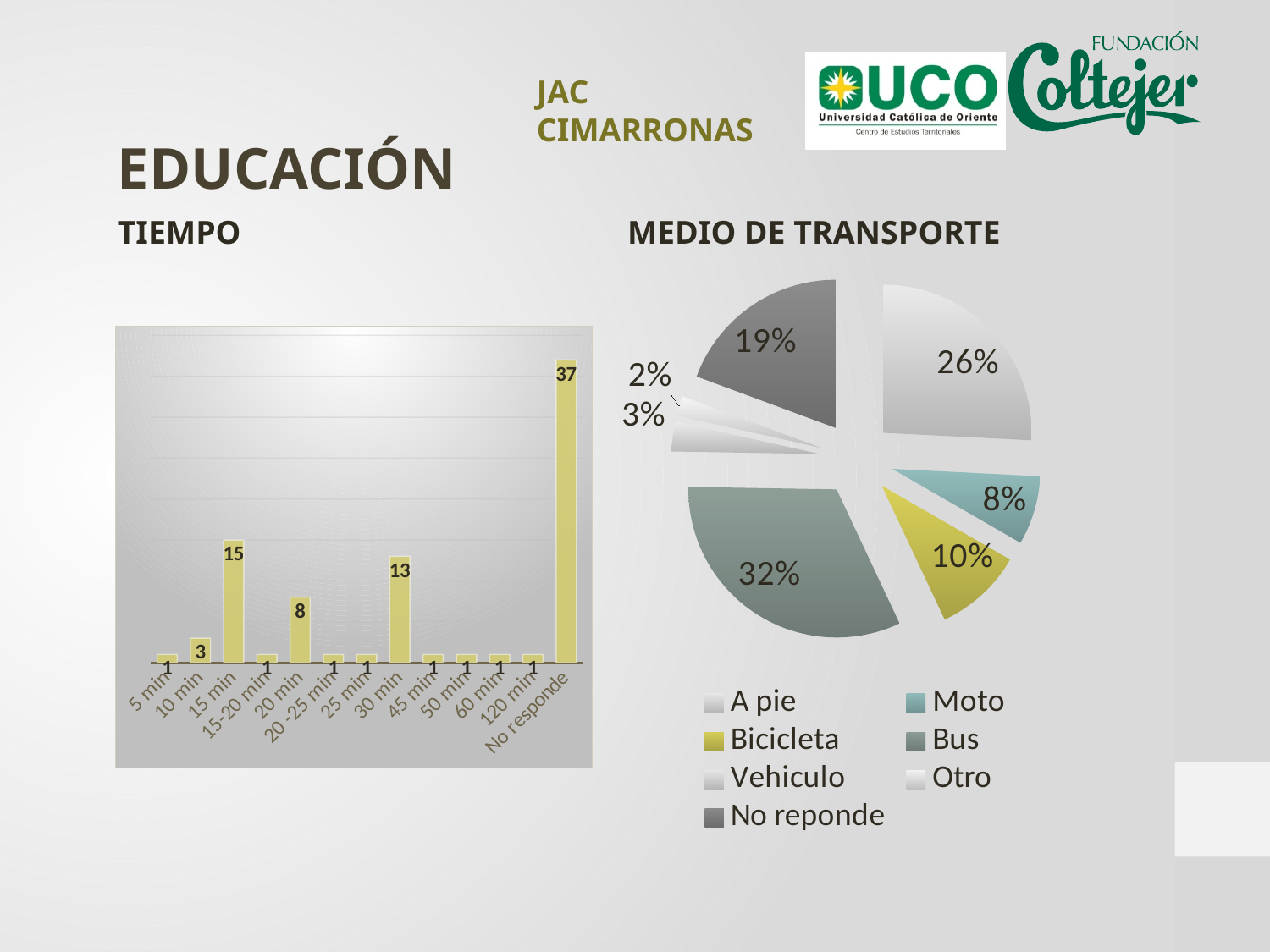
In the TIEMPO bar chart, what is the value for 30 min? 13 In the TIEMPO bar chart, what is the value for 15 min? 15 In the MEDIO DE TRANSPORTE pie chart, what share does Bus have? 32% In the TIEMPO bar chart, which is larger, the value for 10 min or the value for 30 min? 30 min In the TIEMPO bar chart, which category has the highest value? No responde How many entries does the legend of the MEDIO DE TRANSPORTE pie chart list? 7 In the TIEMPO bar chart, what is the value for No responde? 37 In the MEDIO DE TRANSPORTE pie chart, what share does Bicicleta have? 10% What kind of chart is the TIEMPO chart? Bar chart In the MEDIO DE TRANSPORTE pie chart, which category has the largest share? Bus How many categories are shown in the TIEMPO bar chart? 13 In the TIEMPO bar chart, what is the difference between the values for 15 min and 20 min? 7